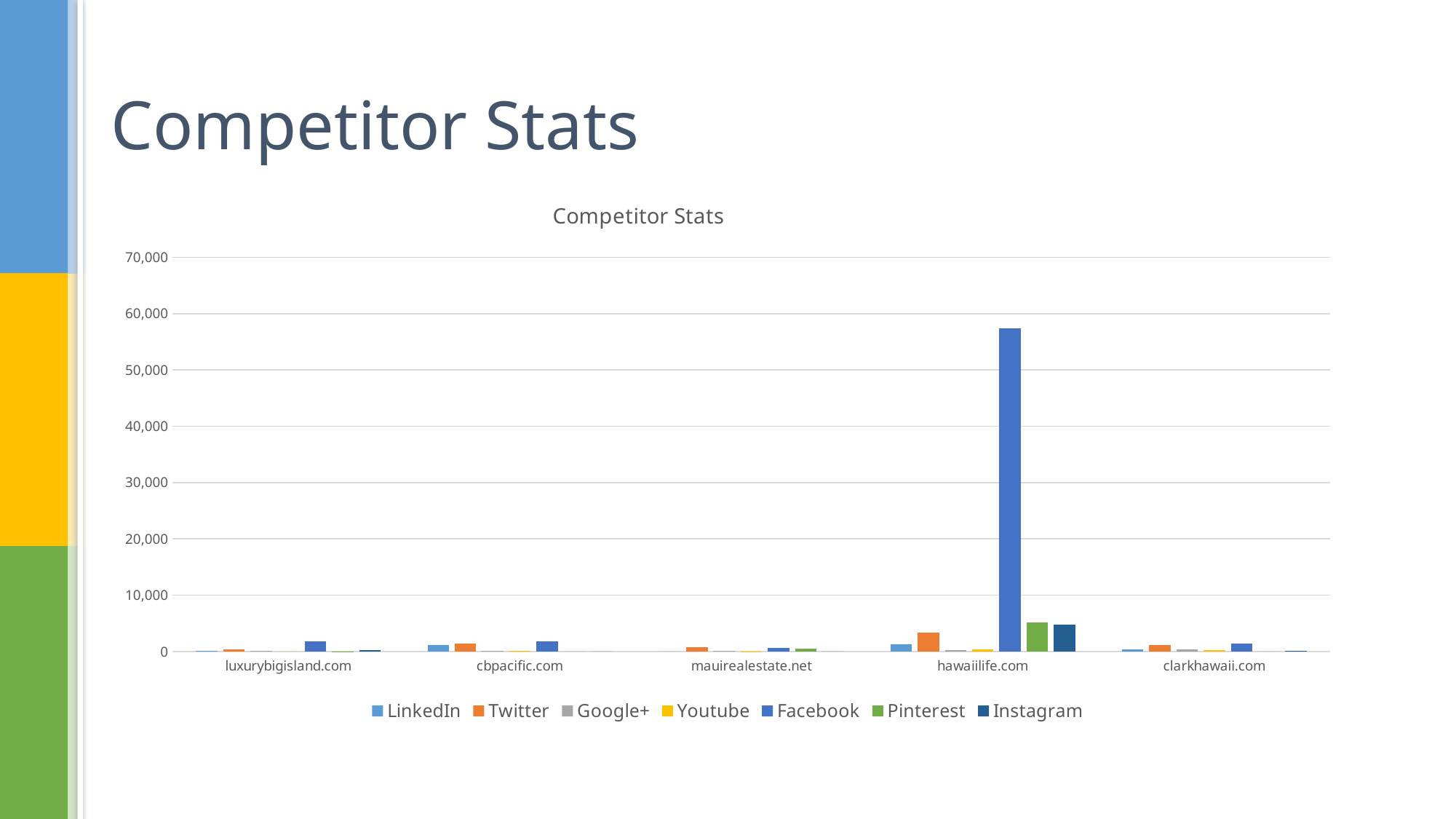
For hawaiilife.com, which is larger: the Facebook value or the Pinterest value? Facebook Which series is shown in yellow in the legend? Youtube Is the Facebook value for hawaiilife.com greater or less than 60,000? less Is the Pinterest value for hawaiilife.com greater or less than 10,000? less What is the title of the chart? Competitor Stats What kind of chart is shown on the slide? bar chart Is the Facebook value for hawaiilife.com greater or less than 50,000? greater How many series does the chart's legend list? 7 For hawaiilife.com, which is larger: the Twitter value or the LinkedIn value? Twitter Which website has the highest Facebook value? hawaiilife.com How many competitor websites are shown on the x axis of the chart? 5 Which series has the tallest bar anywhere in the chart? Facebook